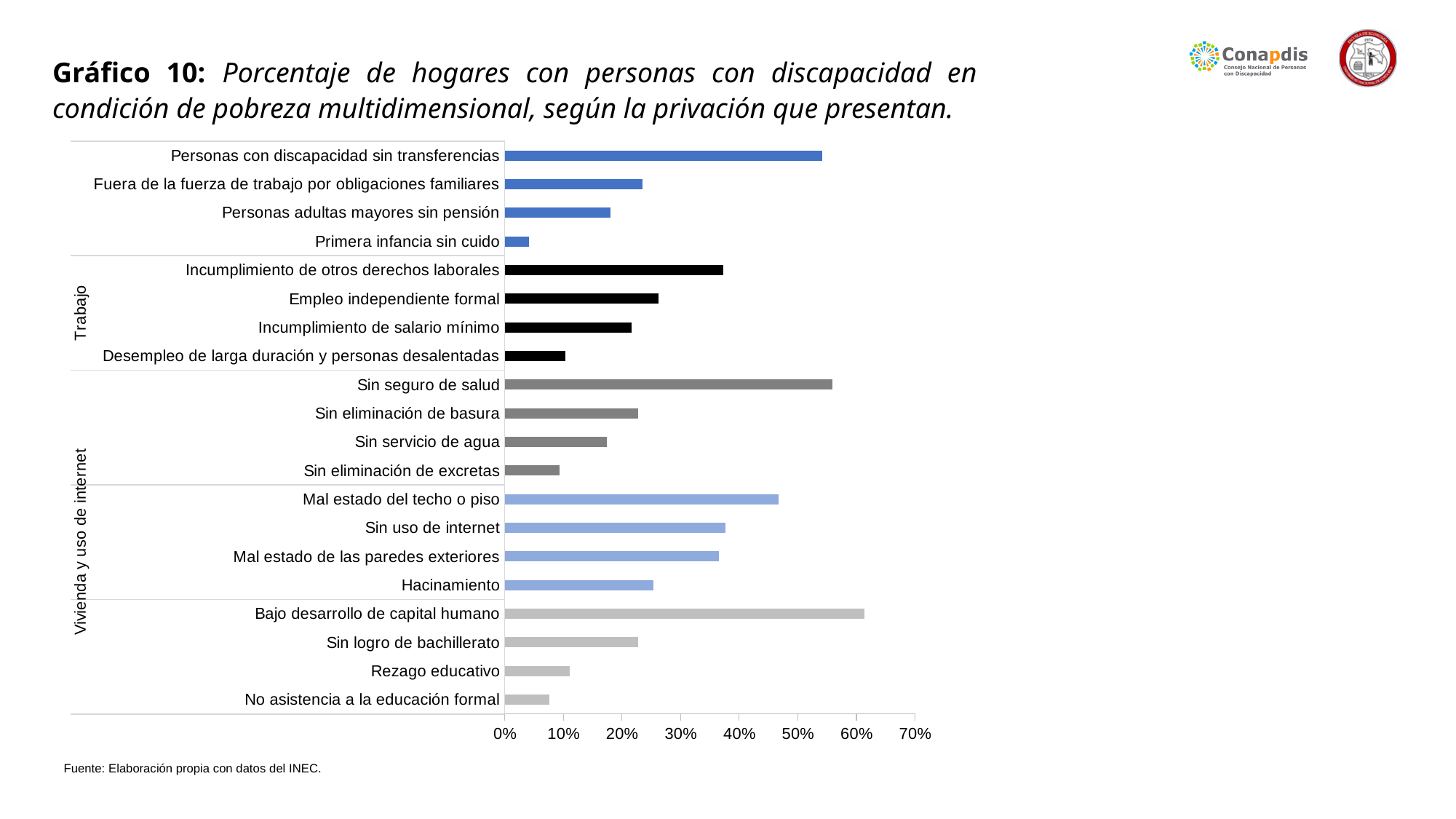
How many categories (privaciones) are plotted in the chart? 20 Is the value for Hacinamiento greater or less than 20%? greater Which category has the highest value in the chart? Bajo desarrollo de capital humano Is the value for Sin seguro de salud greater or less than 50%? greater Is the value for Desempleo de larga duración y personas desalentadas greater or less than 20%? less Which is larger: the value for Mal estado del techo o piso or the value for Sin uso de internet? Mal estado del techo o piso Which category has the lowest value in the chart? Primera infancia sin cuido Which is larger: the value for Incumplimiento de otros derechos laborales or the value for Empleo independiente formal? Incumplimiento de otros derechos laborales According to the note below the chart, what is the source of the data? Elaboración propia con datos del INEC What kind of chart is shown on the slide? Bar chart